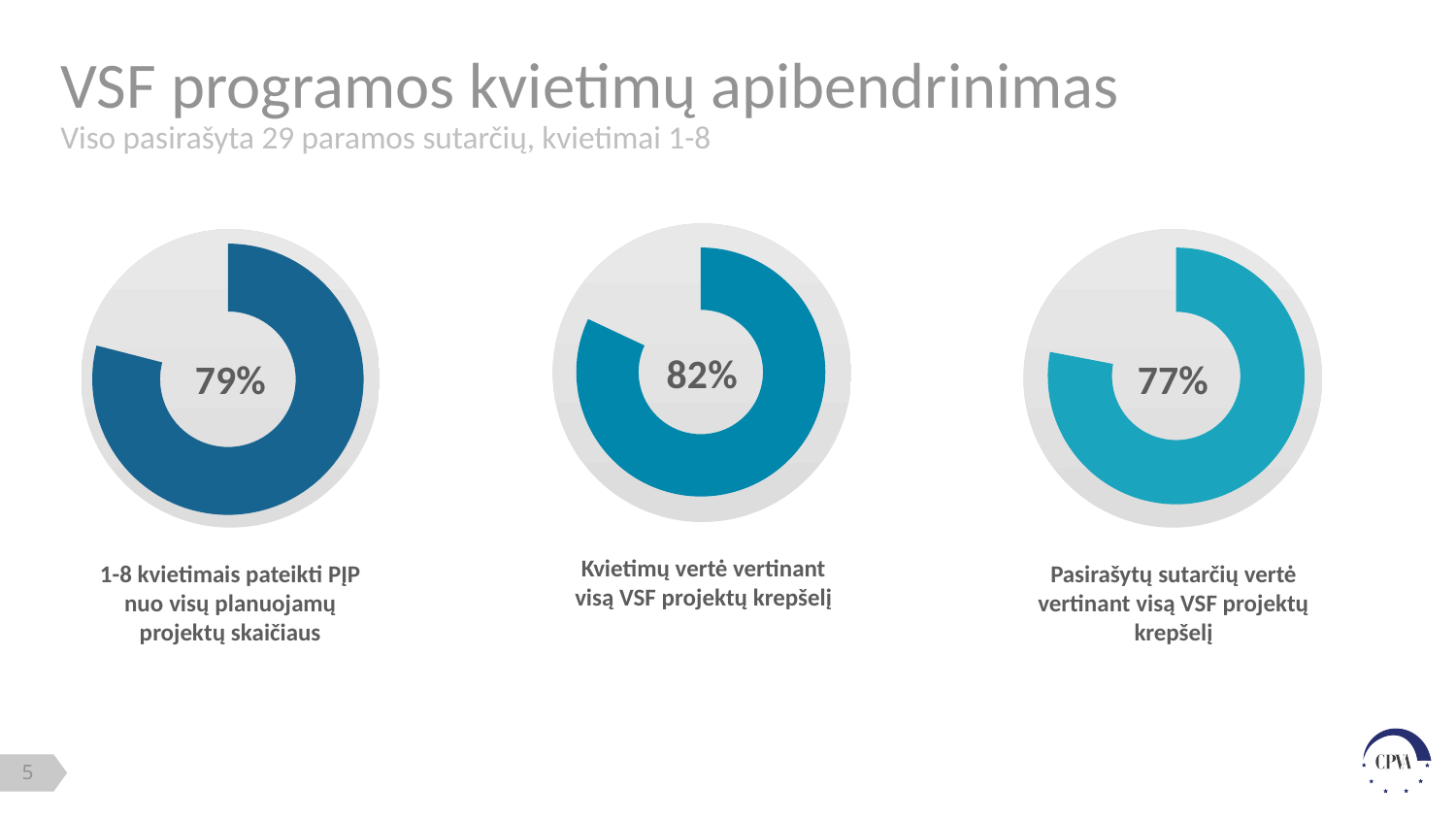
Which of the three donut charts shows the highest percentage? Kvietimų vertė vertinant visą VSF projektų krepšelį (82%) Is the percentage in the middle chart (Kvietimų vertė) larger or smaller than the percentage in the right chart (Pasirašytų sutarčių vertė)? Larger In the left donut chart, what share of the ring is left unfilled (grey) if the filled portion is 79%? 21% What percentage is shown in the left donut chart (1-8 kvietimais pateikti PĮP nuo visų planuojamų projektų skaičiaus)? 79% Which of the three donut charts shows the lowest percentage? Pasirašytų sutarčių vertė vertinant visą VSF projektų krepšelį (77%) What percentage is shown in the middle donut chart (Kvietimų vertė vertinant visą VSF projektų krepšelį)? 82% What is the difference in percentage points between the middle chart (82%) and the right chart (77%)? 5 percentage points What is the title of the slide containing the three donut charts? VSF programos kvietimų apibendrinimas How many donut charts are shown on the slide? 3 What percentage is shown in the right donut chart (Pasirašytų sutarčių vertė vertinant visą VSF projektų krepšelį)? 77% What is the difference in percentage points between the middle chart (82%) and the left chart (79%)? 3 percentage points What kind of chart is used for each of the three figures on the slide? Donut (pie) chart